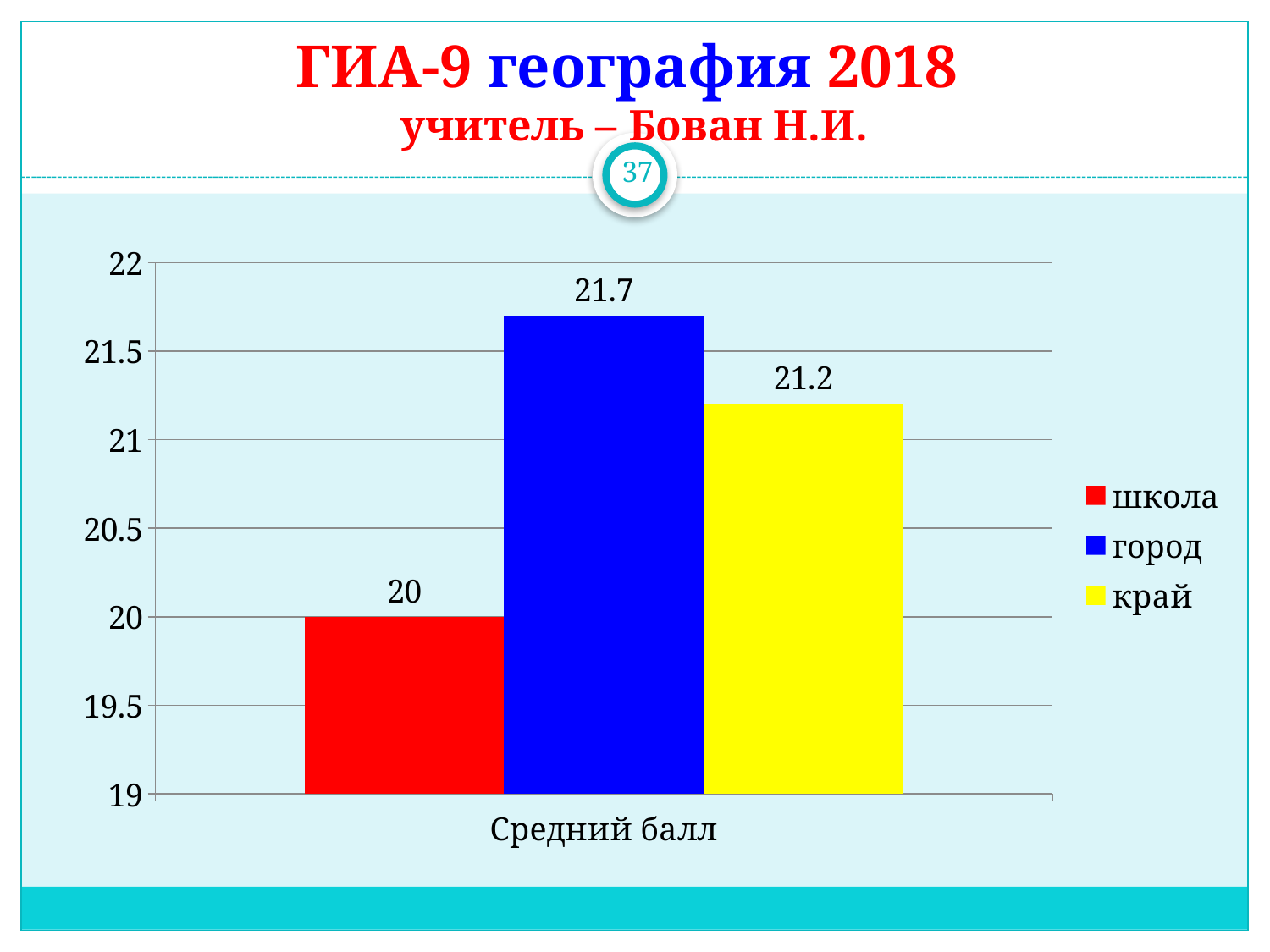
Which series has the lowest value? школа Which is larger, the value for край or the value for школа? край Which series has the highest value? город What is the value for школа in the Средний балл chart? 20 What is the value for город in the Средний балл chart? 21.7 What is the difference between the values for город and школа? 1.7 What is the value for край in the Средний балл chart? 21.2 Is the value for край greater or less than 21? greater How many series does the legend list? 3 What colour is the bar for город? blue What kind of chart is shown on the slide? bar chart What is the difference between the values for город and край? 0.5